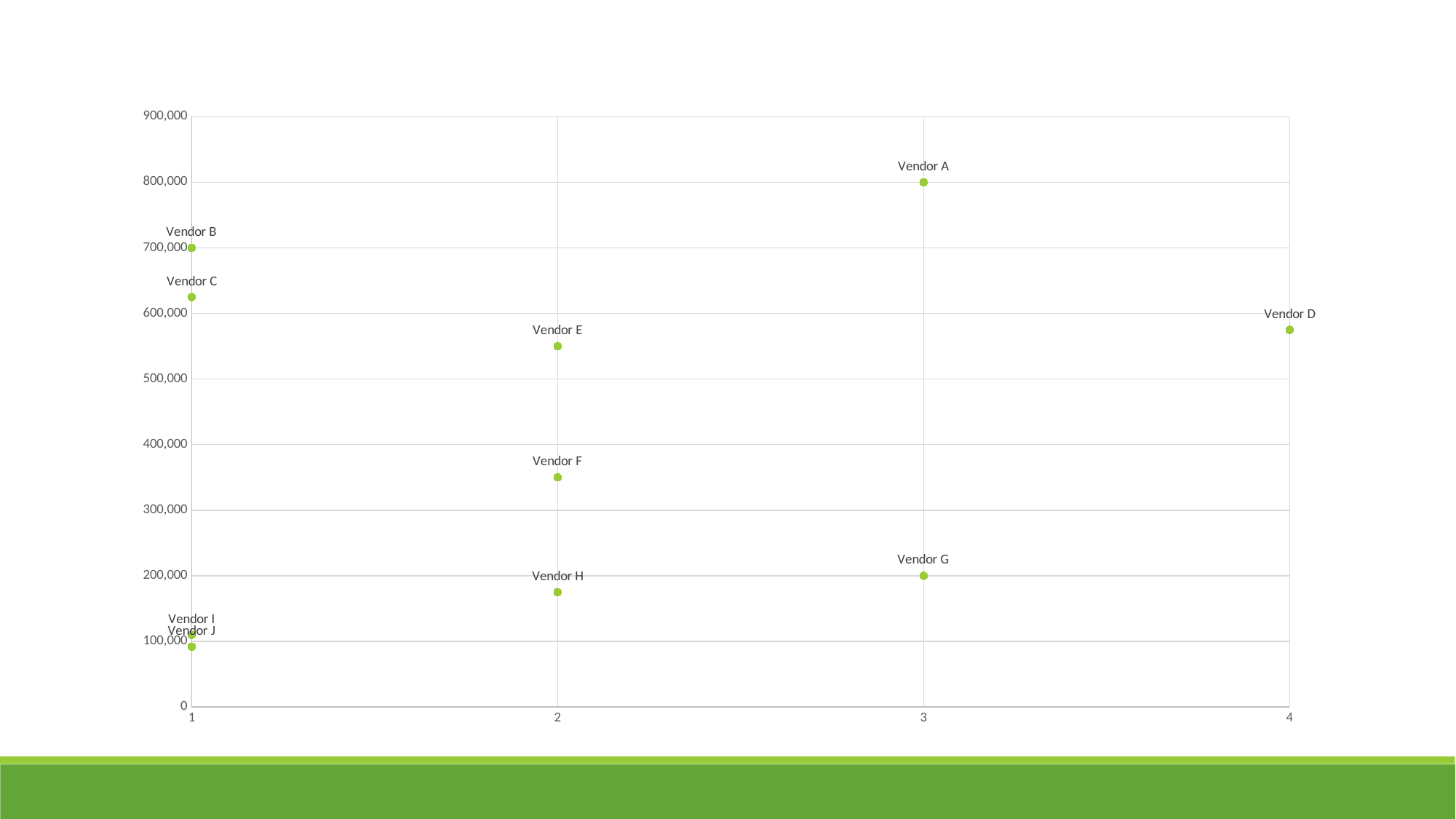
What is the vertical-axis value for Vendor A? 800,000 What is the vertical-axis value for Vendor G? 200,000 What is the vertical-axis value for Vendor B? 700,000 Is the value for Vendor F greater or less than 400,000? less Is the value for Vendor C greater or less than 600,000? greater Which has the higher vertical-axis value, Vendor B or Vendor C? Vendor B What is the horizontal-axis value for Vendor D? 4 Which vendor has the lowest value on the vertical axis? Vendor J Is the value for Vendor H greater or less than 200,000? less Which vendor has the highest value on the vertical axis? Vendor A What kind of chart is shown on the slide? scatter chart How many vendor points are plotted on the chart? 10